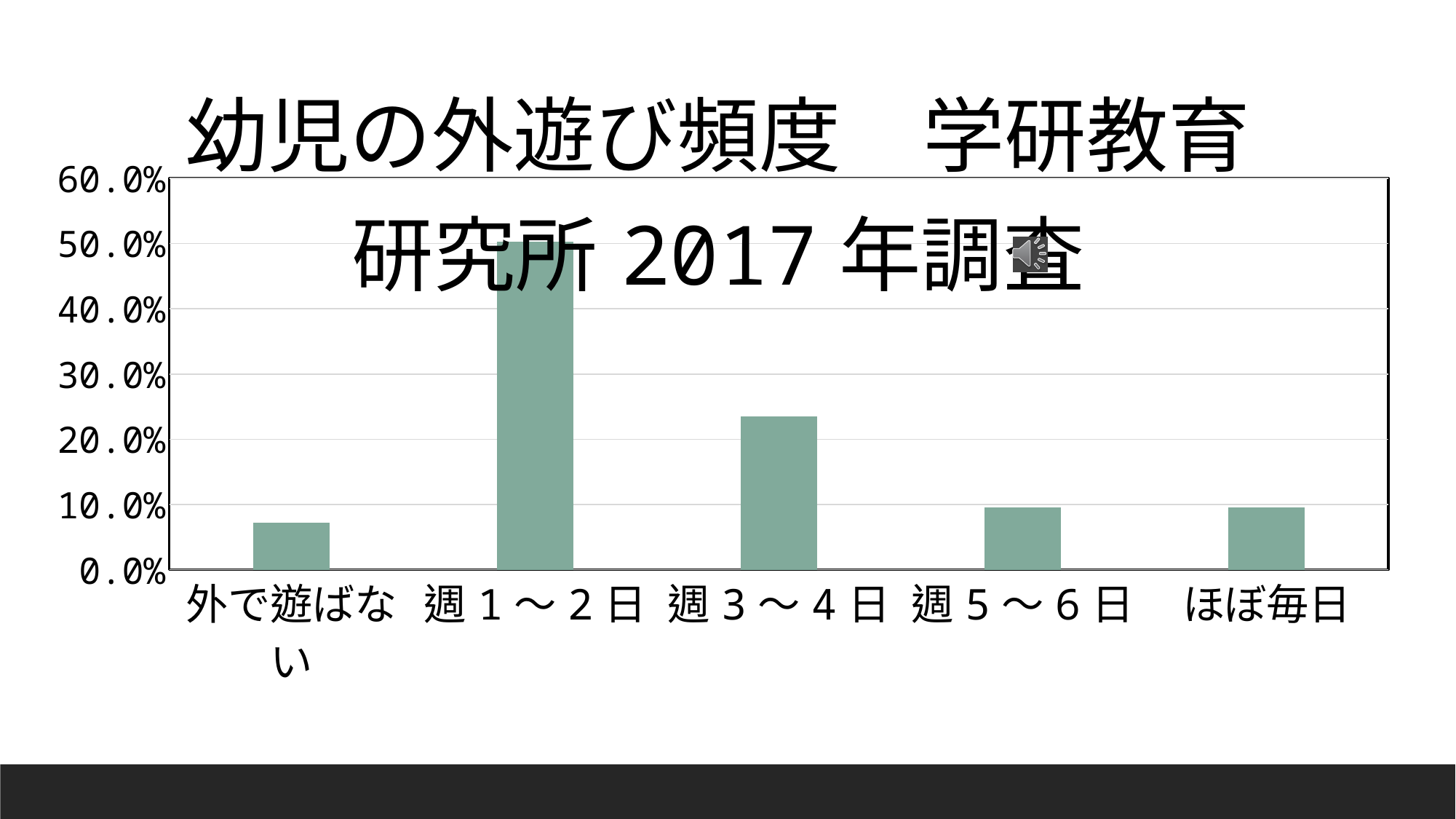
Which is larger, the value for 週１～２日 or the value for 週３～４日? 週１～２日 Which category has the lowest bar? 外で遊ばない How many categories are shown on the x axis of the chart? 5 What kind of chart is shown on the slide? bar chart What is the title of the chart? 幼児の外遊び頻度 学研教育研究所 2017 年調査 Is the value for 週３～４日 greater or less than 20.0%? greater Is the value for 週３～４日 greater or less than 30.0%? less Which is larger, the value for 週３～４日 or the value for 週５～６日? 週３～４日 Is the value for 外で遊ばない greater or less than 10.0%? less Which category has the highest bar? 週１～２日